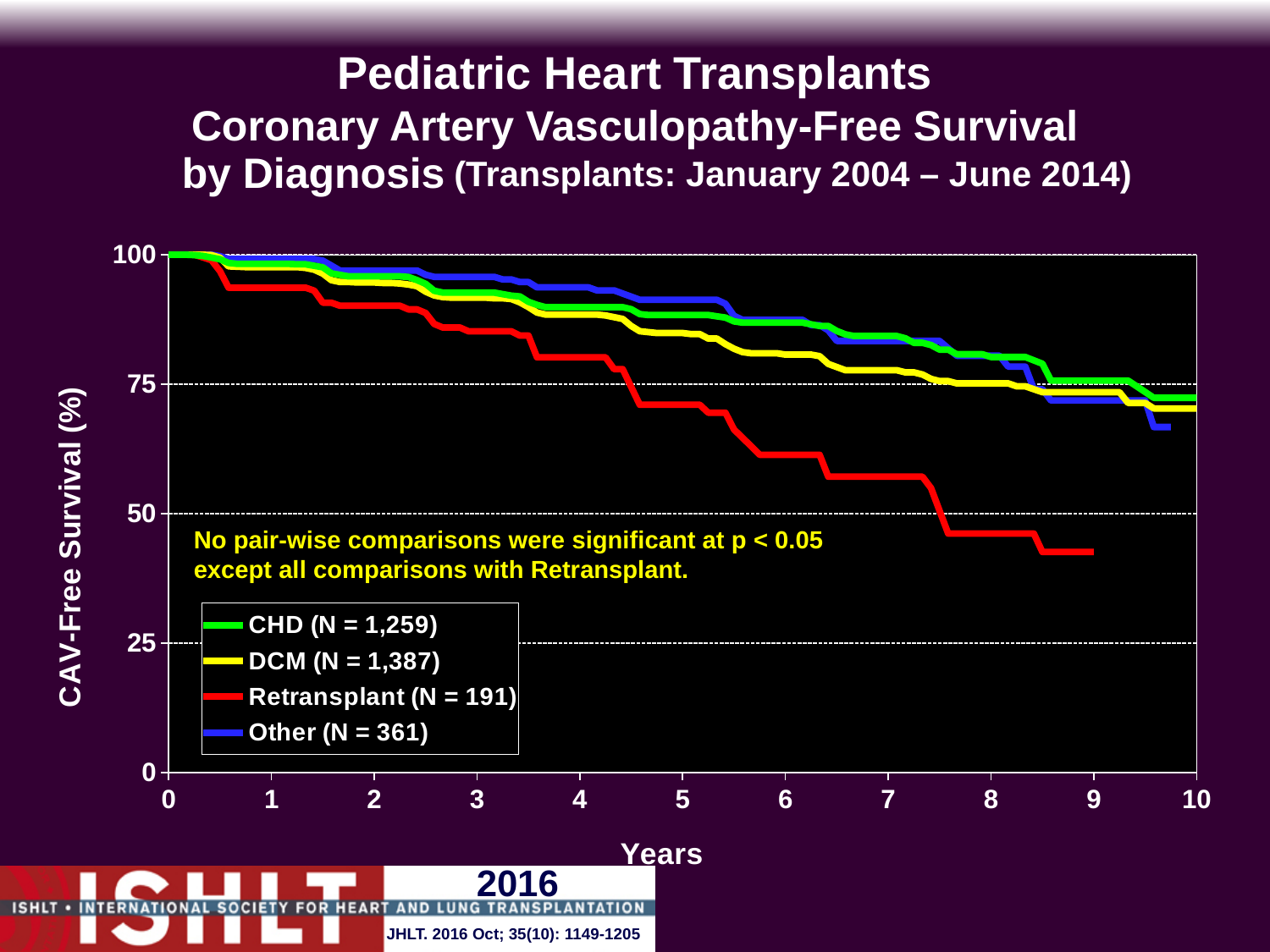
Is the CAV-free survival for the CHD group at 10 years greater or less than 50? greater At 8 years, which has higher CAV-free survival: the CHD group or the Retransplant group? CHD Is the CAV-free survival for the Retransplant group at 9 years greater or less than 50? less Is the CAV-free survival for the DCM group at 5 years greater or less than 75? greater What is the N for the DCM group shown in the legend? 1,387 How many series does the legend list? 4 Which diagnosis group has the lowest CAV-free survival at 9 years? Retransplant What kind of chart is shown on the slide? line chart What colour is the line for the Other group? blue What is the N for the Retransplant group shown in the legend? 191 Do the CAV-free survival curves rise or fall as years increase? fall